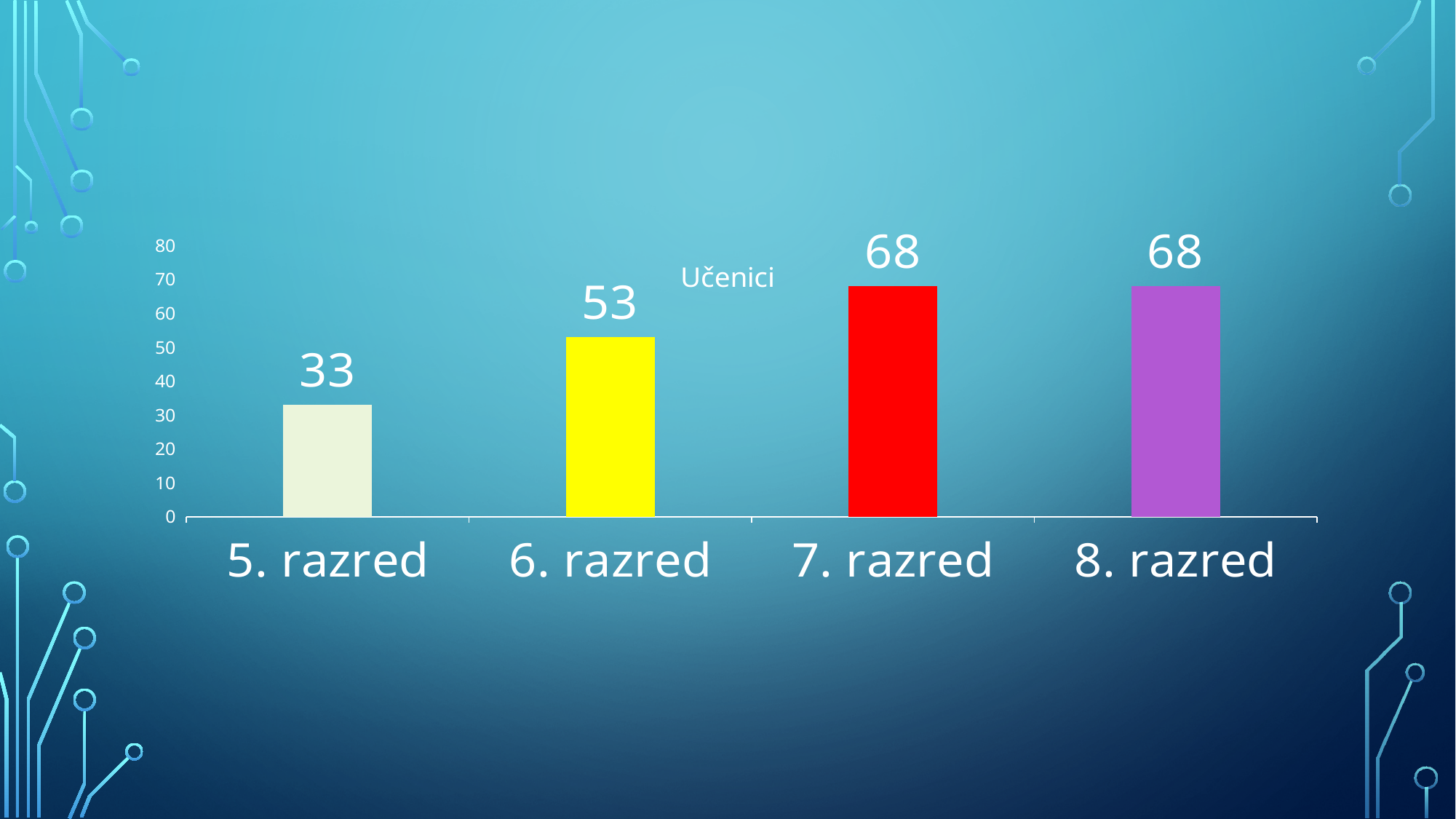
Is the value for 5. razred greater or less than 40? less What is the value for 5. razred? 33 What kind of chart is shown on the slide? bar chart Which is larger, the value for 6. razred or the value for 8. razred? 8. razred Which category has the lowest value? 5. razred What is the value for 7. razred? 68 Do the values rise or fall from 5. razred to 7. razred? rise What is the value for 6. razred? 53 What is the title of the chart? Učenici What is the difference between the values for 6. razred and 5. razred? 20 How many categories are shown on the x axis? 4 What is the difference between the values for 7. razred and 6. razred? 15